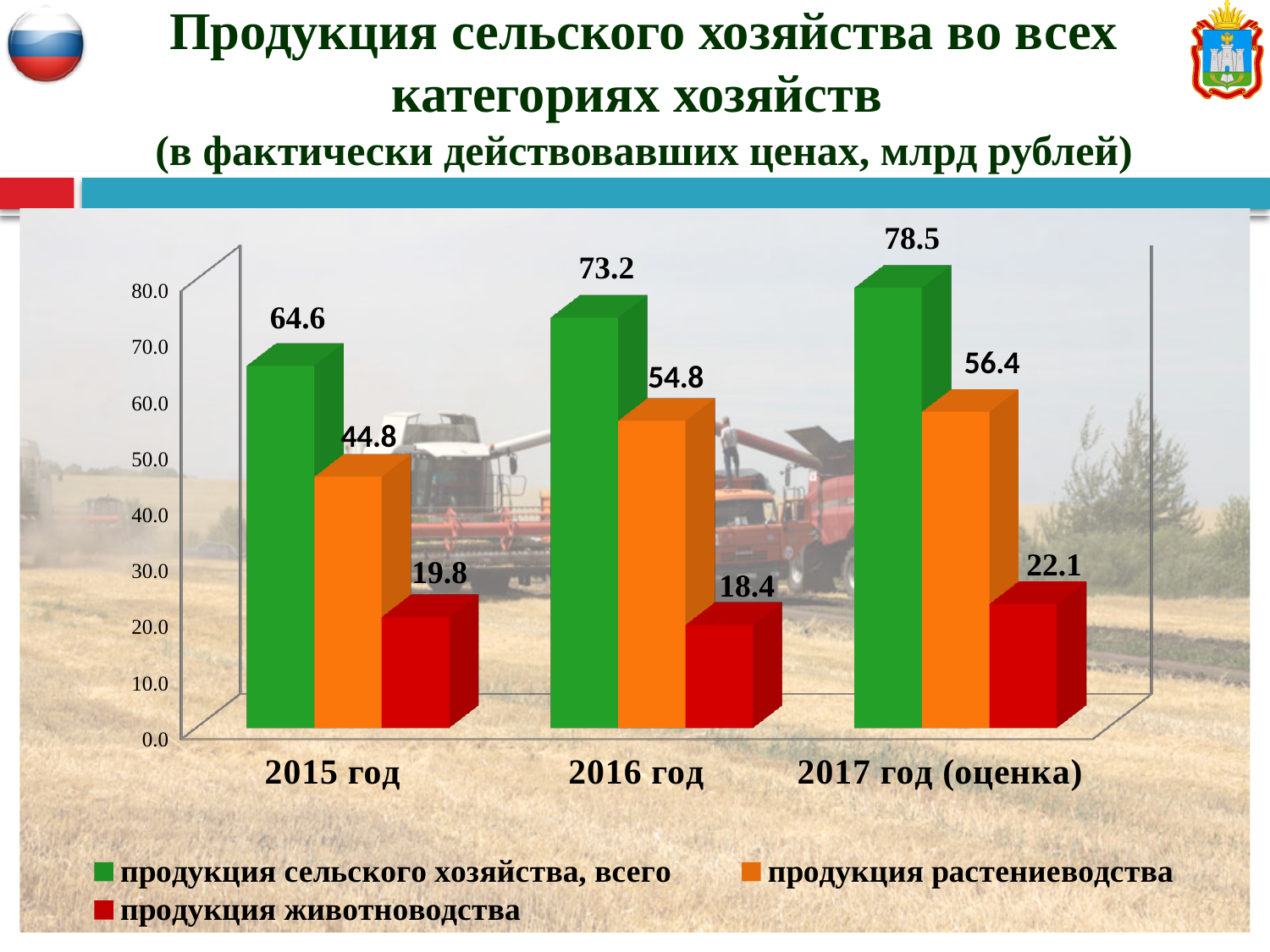
Does продукция растениеводства rise or fall from 2015 год to 2017 год (оценка)? rise In which year is продукция сельского хозяйства, всего the highest? 2017 год (оценка) How many year categories are shown on the x axis? 3 What is the value of продукция животноводства for 2017 год (оценка)? 22.1 What kind of chart is shown on the slide? bar chart How many series does the legend list? 3 Is the value of продукция растениеводства for 2016 год greater or less than 50.0? greater Which is larger: продукция растениеводства in 2015 год or продукция растениеводства in 2017 год (оценка)? 2017 год (оценка) What is the value of продукция растениеводства for 2016 год? 54.8 In which year is продукция животноводства the lowest? 2016 год What is the difference between продукция сельского хозяйства, всего in 2017 год (оценка) and in 2015 год? 13.9 What is the value of продукция сельского хозяйства, всего for 2015 год? 64.6